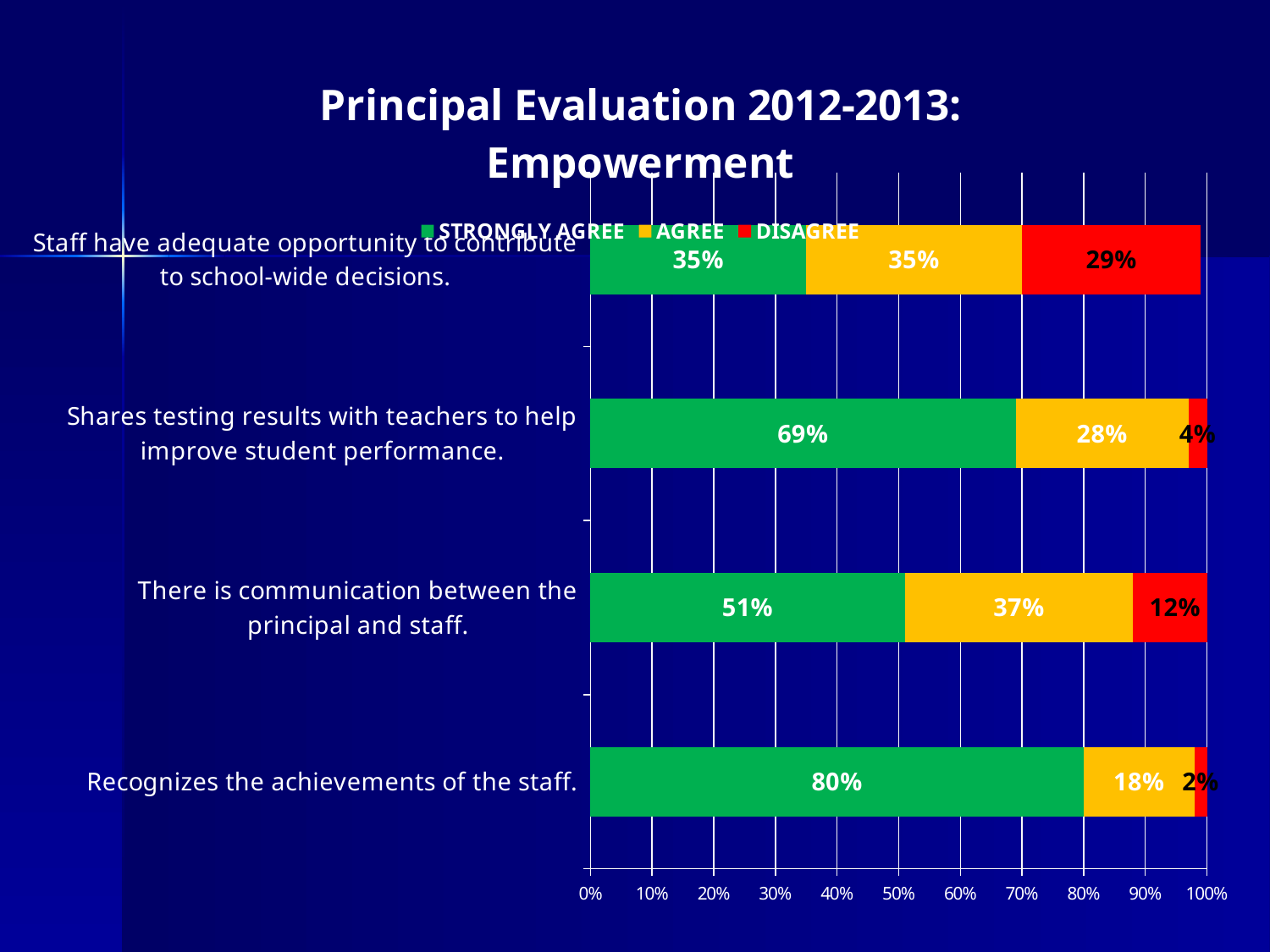
What kind of chart is shown on the slide? Stacked bar chart What is the title of the chart? Principal Evaluation 2012-2013: Empowerment What is the Disagree value for "Staff have adequate opportunity to contribute to school-wide decisions."? 29% Which is larger: the Disagree value for "There is communication between the principal and staff." or the Disagree value for "Shares testing results with teachers to help improve student performance."? There is communication between the principal and staff. Is the Strongly Agree value for "Shares testing results with teachers to help improve student performance." greater or less than 60%? greater What is the Strongly Agree value for "Recognizes the achievements of the staff."? 80% What is the difference between the Strongly Agree values for "Recognizes the achievements of the staff." and "There is communication between the principal and staff."? 29% What is the Agree value for "Shares testing results with teachers to help improve student performance."? 28% Which statement has the highest Strongly Agree value? Recognizes the achievements of the staff. How many series does the legend list? 3 How many categories (statements) are plotted in the chart? 4 Which statement has the lowest Strongly Agree value? Staff have adequate opportunity to contribute to school-wide decisions.